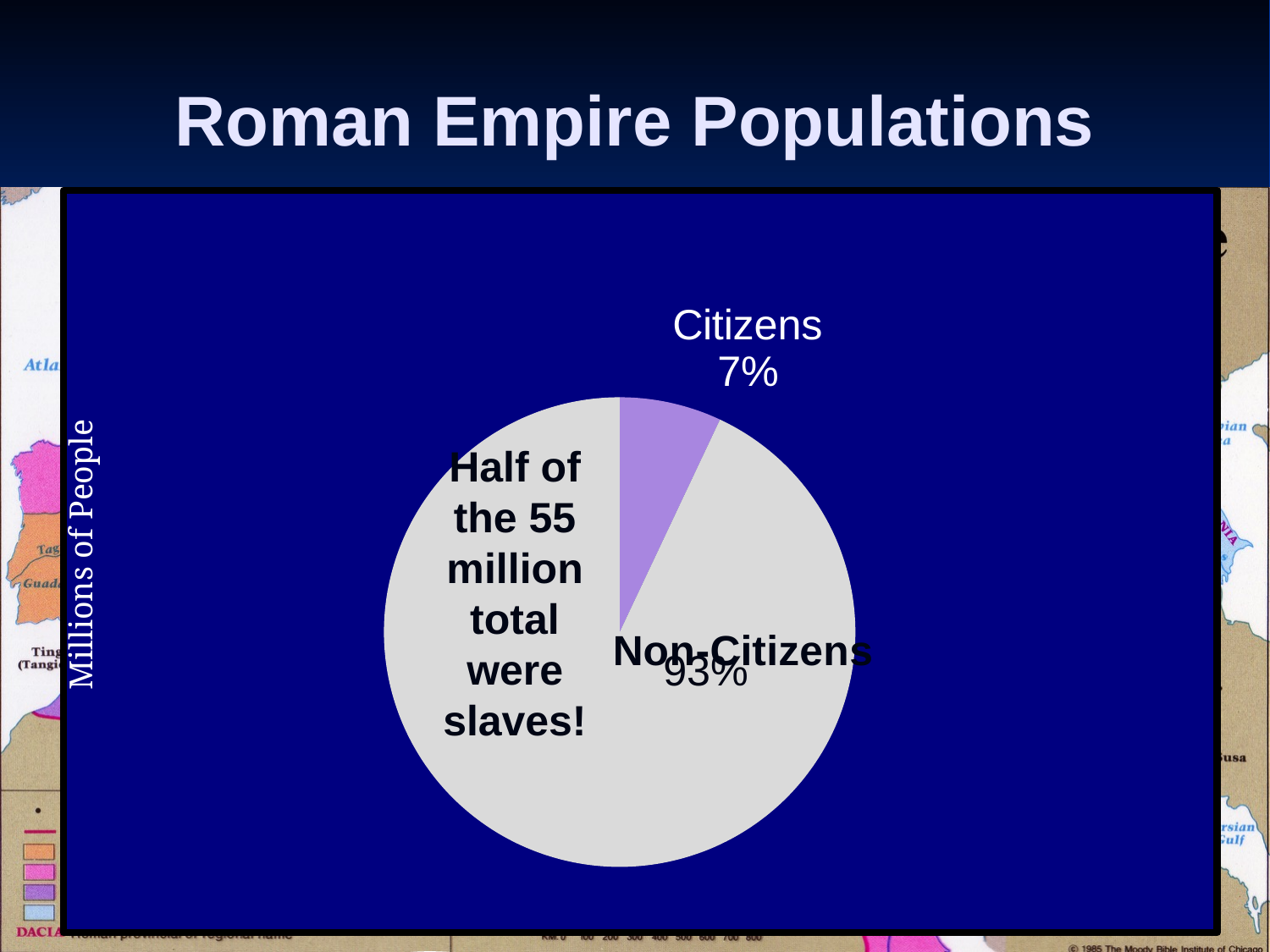
According to the text on the chart, what was the total population in millions? 55 million Which slice of the pie is the largest? Non-Citizens Which is larger, the Citizens slice or the Non-Citizens slice? Non-Citizens What is the title of the slide containing the pie chart? Roman Empire Populations Which slice of the pie is the smallest? Citizens What colour is the Citizens slice of the pie? purple How many slices does the pie chart have? 2 What share of the pie is labelled Citizens? 7% What share of the pie is labelled Non-Citizens? 93% What kind of chart is shown on the slide? pie chart What is the difference in percentage points between the Non-Citizens share and the Citizens share? 86